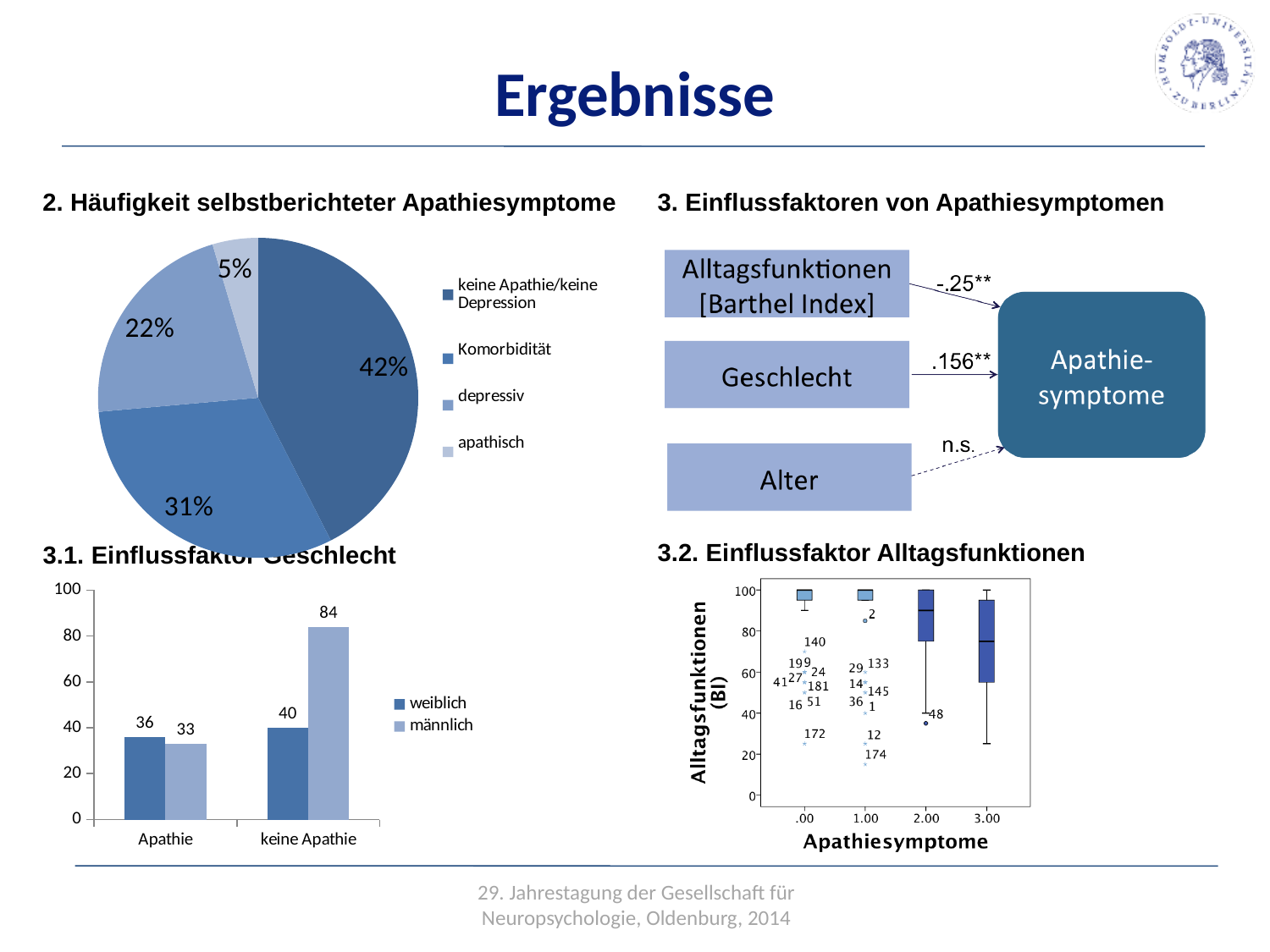
In the bar chart under '3.1. Einflussfaktor Geschlecht', which is larger in the 'Apathie' group, 'weiblich' or 'männlich'? weiblich In the bar chart under '3.1. Einflussfaktor Geschlecht', what is the value for 'männlich' in the 'keine Apathie' group? 84 In the pie chart under '2. Häufigkeit selbstberichteter Apathiesymptome', what share is labelled for 'keine Apathie/keine Depression'? 42% How many categories does the legend of the pie chart under '2. Häufigkeit selbstberichteter Apathiesymptome' list? 4 In the pie chart under '2. Häufigkeit selbstberichteter Apathiesymptome', what share is labelled for the 'apathisch' slice? 5% How many series does the legend of the bar chart under '3.1. Einflussfaktor Geschlecht' list? 2 In the bar chart under '3.1. Einflussfaktor Geschlecht', what is the difference between 'männlich' and 'weiblich' in the 'keine Apathie' group? 44 In the pie chart under '2. Häufigkeit selbstberichteter Apathiesymptome', which category has the smallest slice? apathisch In the chart under '3.2. Einflussfaktor Alltagsfunktionen', what is the label of the x axis? Apathiesymptome In the bar chart under '3.1. Einflussfaktor Geschlecht', what is the value for 'weiblich' in the 'Apathie' group? 36 In the pie chart under '2. Häufigkeit selbstberichteter Apathiesymptome', which category has the largest slice? keine Apathie/keine Depression What kind of chart is shown under '3.1. Einflussfaktor Geschlecht'? bar chart